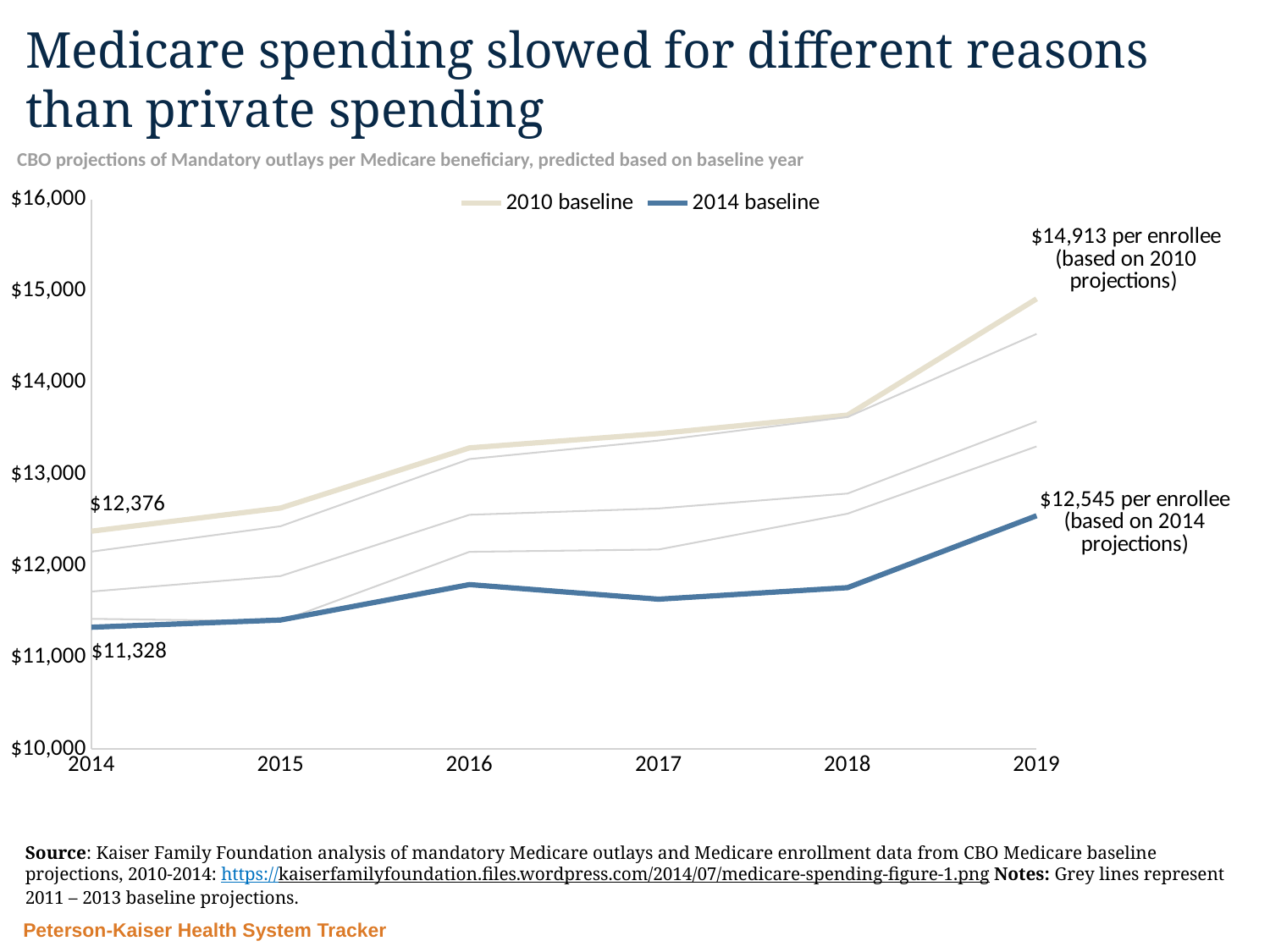
Which series has the higher value in 2019, the 2010 baseline or the 2014 baseline? 2010 baseline How many series does the legend list? 2 What is the difference between the 2010 baseline and 2014 baseline values for 2014? $1,048 What kind of chart is shown on the slide? line chart How many years are shown on the x axis? 6 Is the 2014 baseline value for 2017 greater or less than $12,000? less What is the projected spending per enrollee in 2019 based on the 2010 projections? $14,913 What is the 2010 baseline projection per Medicare beneficiary for 2014? $12,376 What is the difference between the 2010 baseline and 2014 baseline projections for 2019? $2,368 What is the 2014 baseline projection per Medicare beneficiary for 2014? $11,328 Is the 2010 baseline value for 2018 greater or less than $13,000? greater What is the projected spending per enrollee in 2019 based on the 2014 projections? $12,545